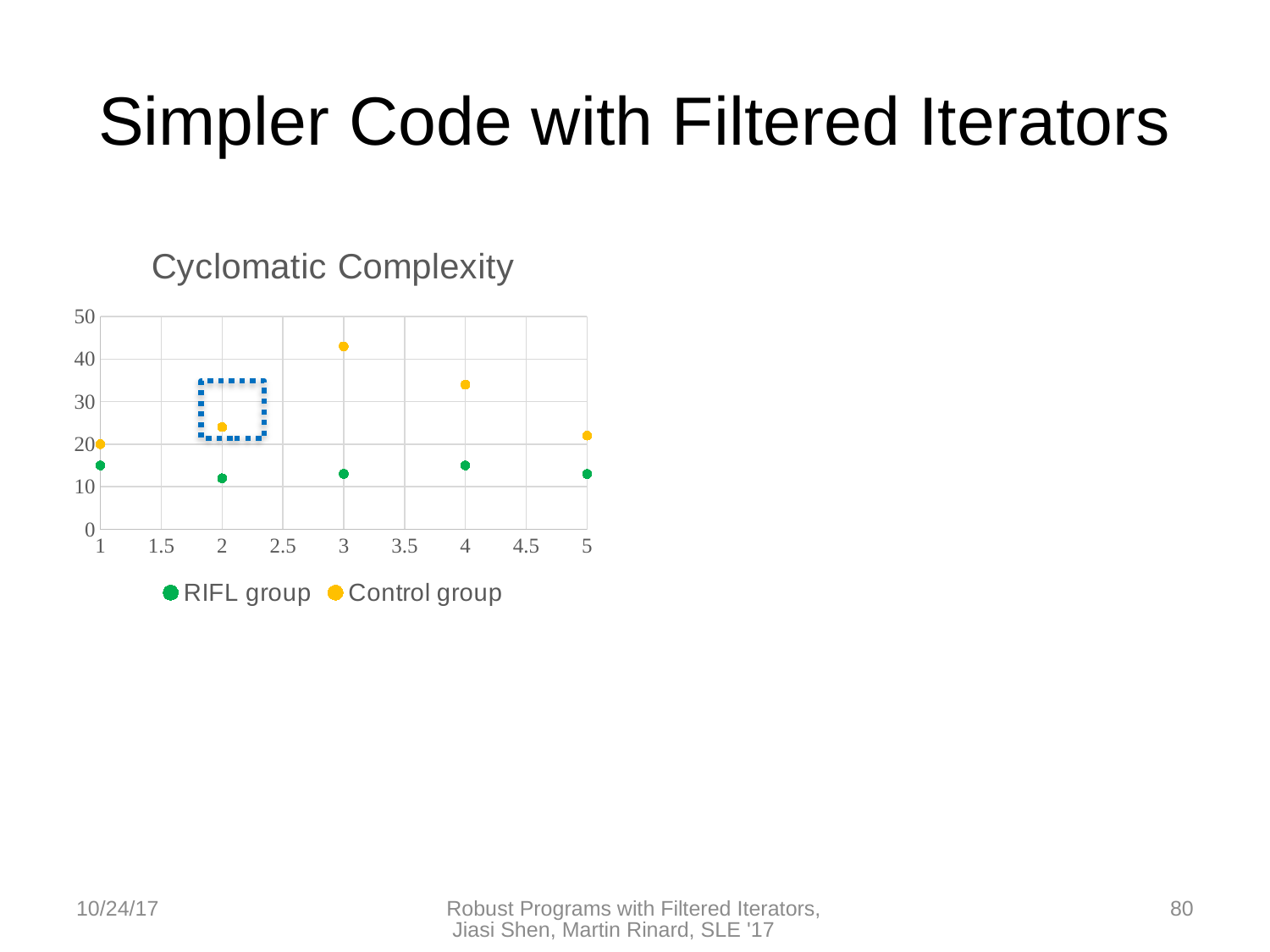
What is the title of the chart? Cyclomatic Complexity How many data points are plotted for the Control group series? 5 What kind of chart is shown on the slide? Scatter chart How many series does the legend list? 2 Which series is shown in green in the legend? RIFL group At x = 3, which series has the larger value, RIFL group or Control group? Control group Is the Control group value at x = 4 greater or less than 30? greater At which x value does the Control group reach its highest value? 3 Is the RIFL group value at x = 1 greater or less than 20? less For the Control group, which is larger: the value at x = 4 or the value at x = 5? x = 4 Is the Control group value at x = 3 greater or less than 40? greater